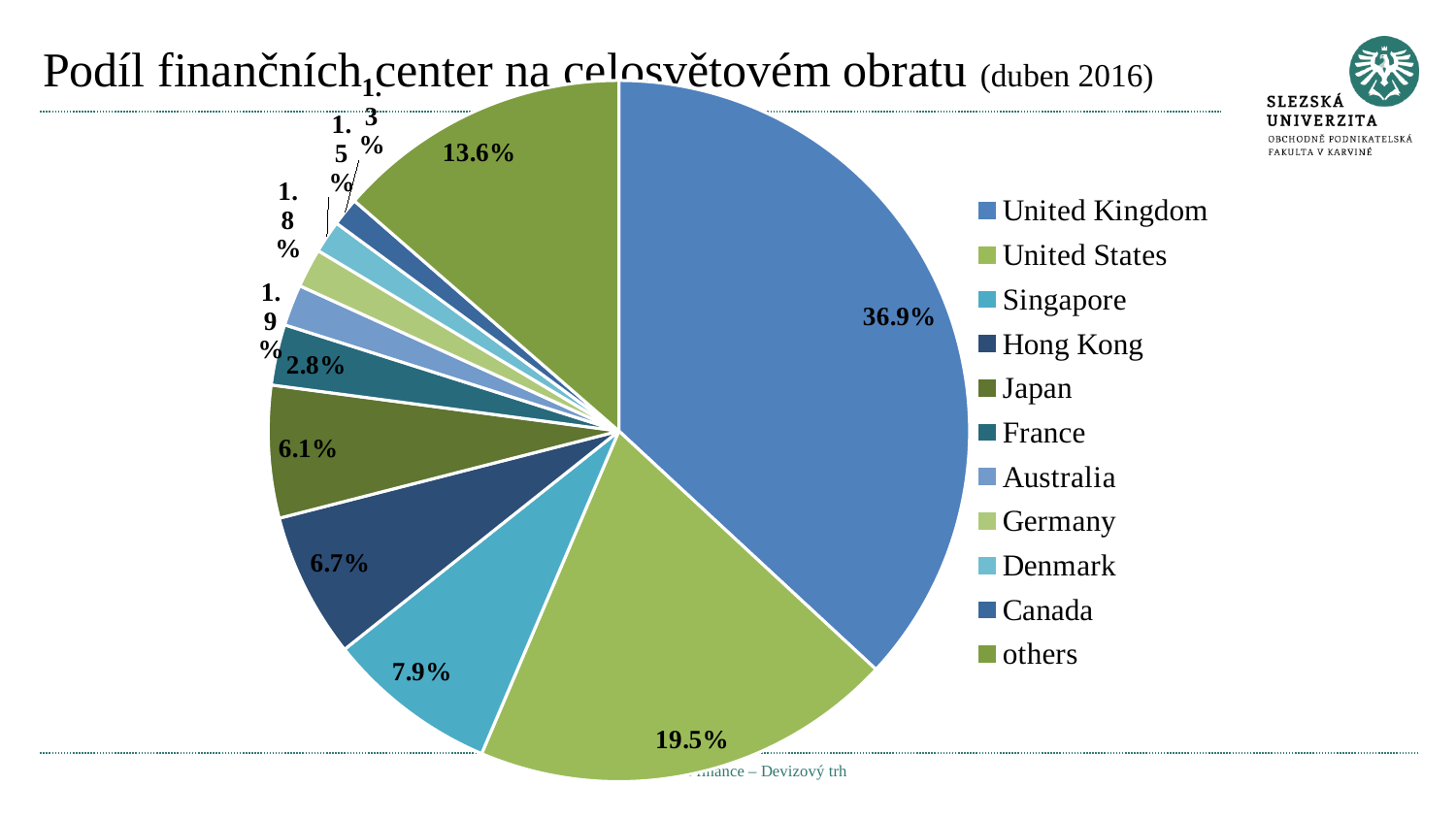
What is the difference between the shares of United Kingdom and United States? 17.4% What share of the pie does Japan have? 6.1% What share of the pie does Singapore have? 7.9% What type of chart is shown on the slide? pie chart What share of the pie does United States have? 19.5% What share of the pie does United Kingdom have? 36.9% How many categories does the legend list? 11 What share of the pie does Hong Kong have? 6.7% Which is larger, the share of Singapore or the share of Hong Kong? Singapore Which category has the largest slice of the pie? United Kingdom What share of the pie does the 'others' slice have? 13.6% What share of the pie does France have? 2.8%